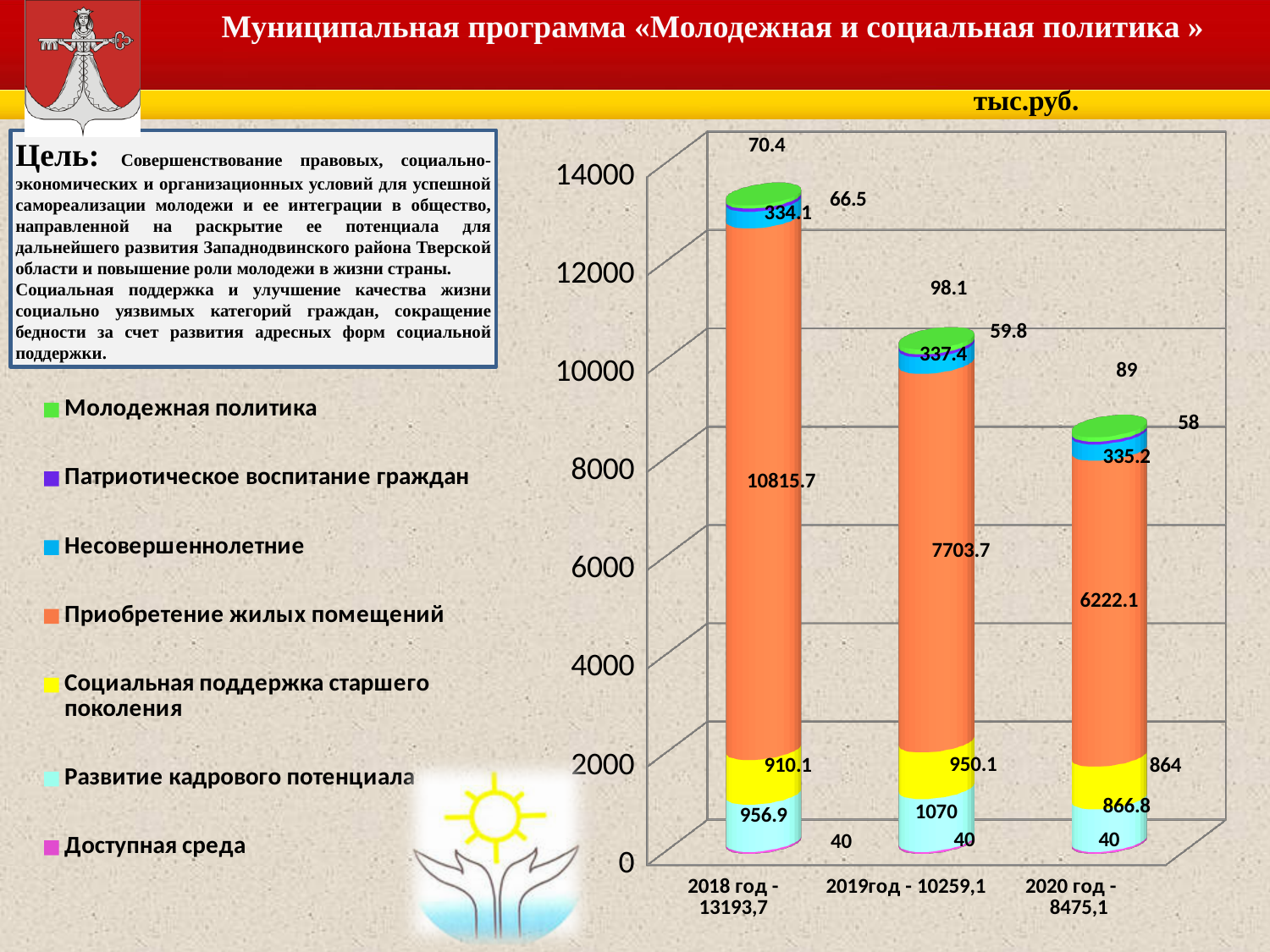
What is the value for Приобретение жилых помещений in 2018? 10815.7 What is the value for Развитие кадрового потенциала in 2019? 1070 What is the difference between the Приобретение жилых помещений values for 2018 and 2019? 3112 What is the total of the stacked bar for 2020 as shown in its axis label? 8475,1 What is the value for Молодежная политика in 2019? 98.1 Which is larger: Социальная поддержка старшего поколения in 2019 or in 2020? 2019 How many series does the legend list? 7 What is the value for Приобретение жилых помещений in 2020? 6222.1 Which year has the highest value for Приобретение жилых помещений? 2018 What is the value for Доступная среда in 2020? 40 How many year categories are plotted on the x axis? 3 What type of chart is shown on the slide? bar chart